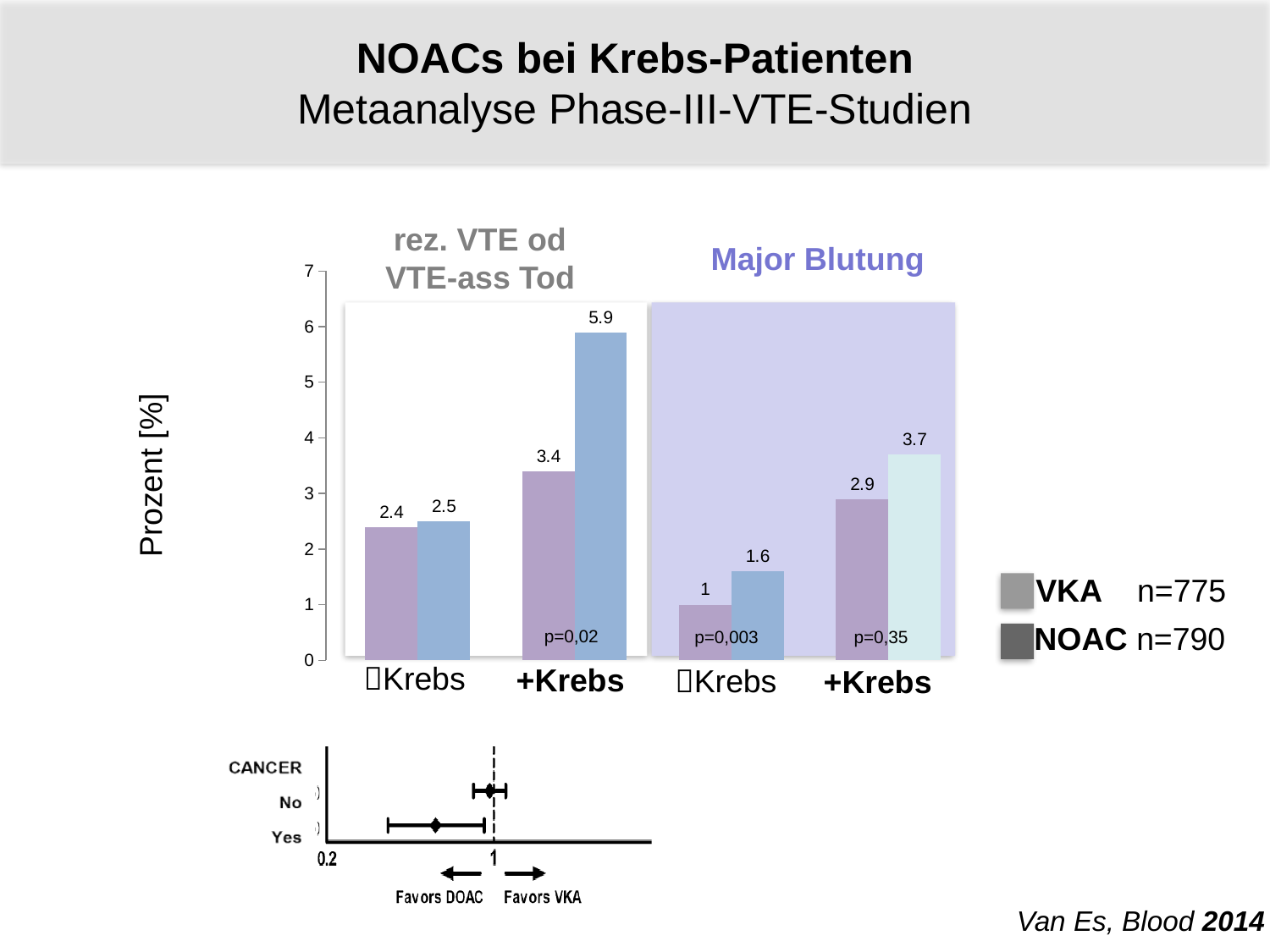
Which bar in the bar chart has the lowest value? The shorter Krebs (without plus sign) bar in the 'Major Blutung' section (1) Which bar in the bar chart has the highest value? The taller +Krebs bar in the 'rez. VTE od VTE-ass Tod' section (5.9) How many series does the legend of the bar chart list? 2 What type of chart is the main chart on the slide? Bar chart In the 'Major Blutung' section, what is the difference between the NOAC and VKA values for +Krebs? 0.8 In the 'rez. VTE od VTE-ass Tod' section, what is the difference between the NOAC and VKA values for +Krebs? 2.5 According to the legend, what is the n for the VKA group? n=775